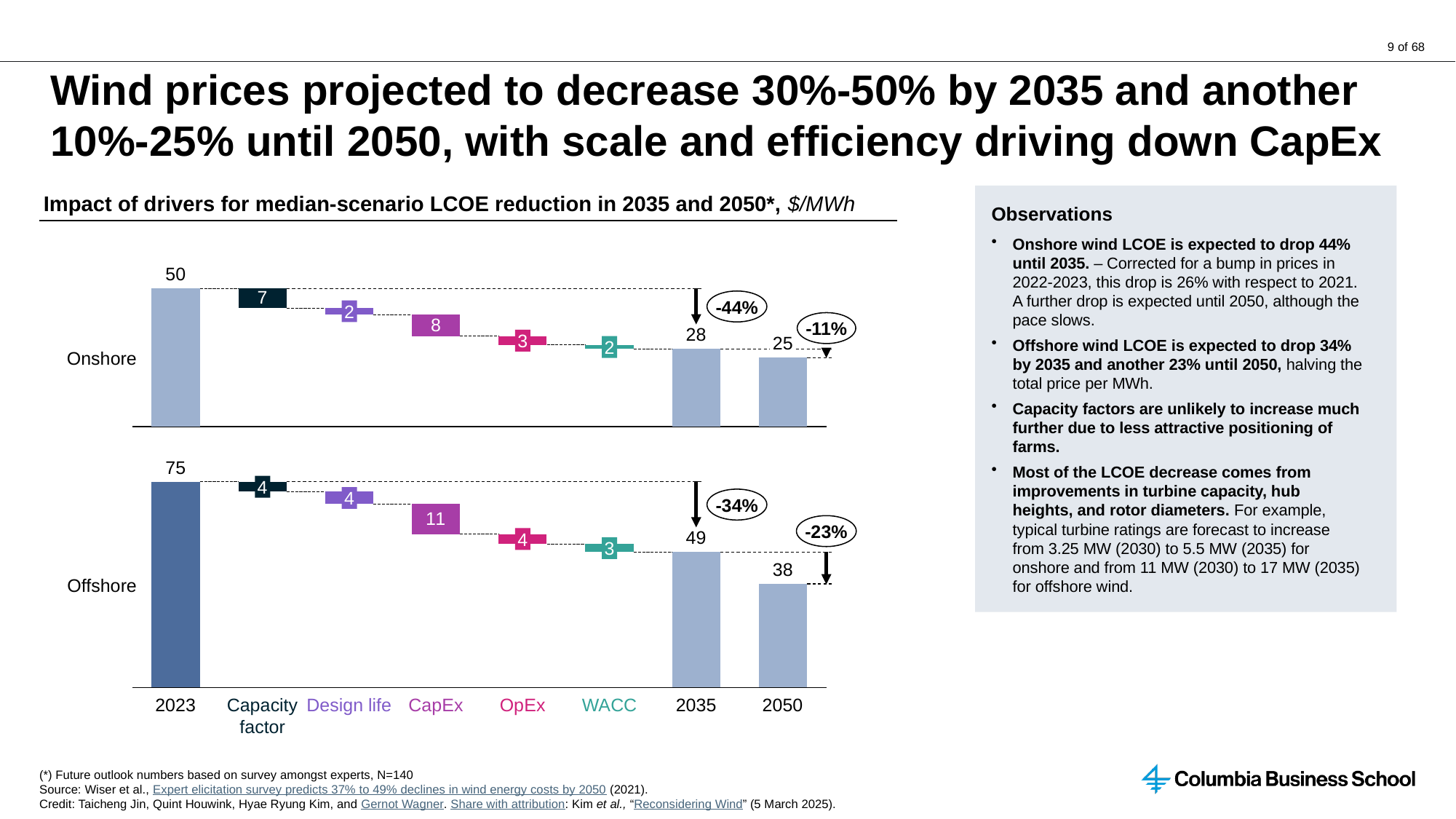
In the Offshore chart, what is the reduction attributed to CapEx? 11 How many reduction drivers are shown between 2023 and 2035 in each chart? 5 In the Offshore chart, what is the LCOE value shown for 2035? 49 In the Onshore chart, what is the LCOE value shown for 2023? 50 Which is larger: the Onshore 2050 value or the Offshore 2050 value? Offshore 2050 In the Onshore chart, what is the reduction attributed to CapEx? 8 In the Offshore chart, what percentage change is shown between 2035 and 2050? -23% In the Offshore chart, which driver contributes the smallest reduction? WACC In the Onshore chart, which driver contributes the largest reduction? CapEx What kind of chart is used to show the LCOE reduction drivers? Waterfall bar chart In the Onshore chart, what is the difference between the 2023 value and the 2035 value? 22 In the Offshore chart, what is the difference between the 2035 value and the 2050 value? 11